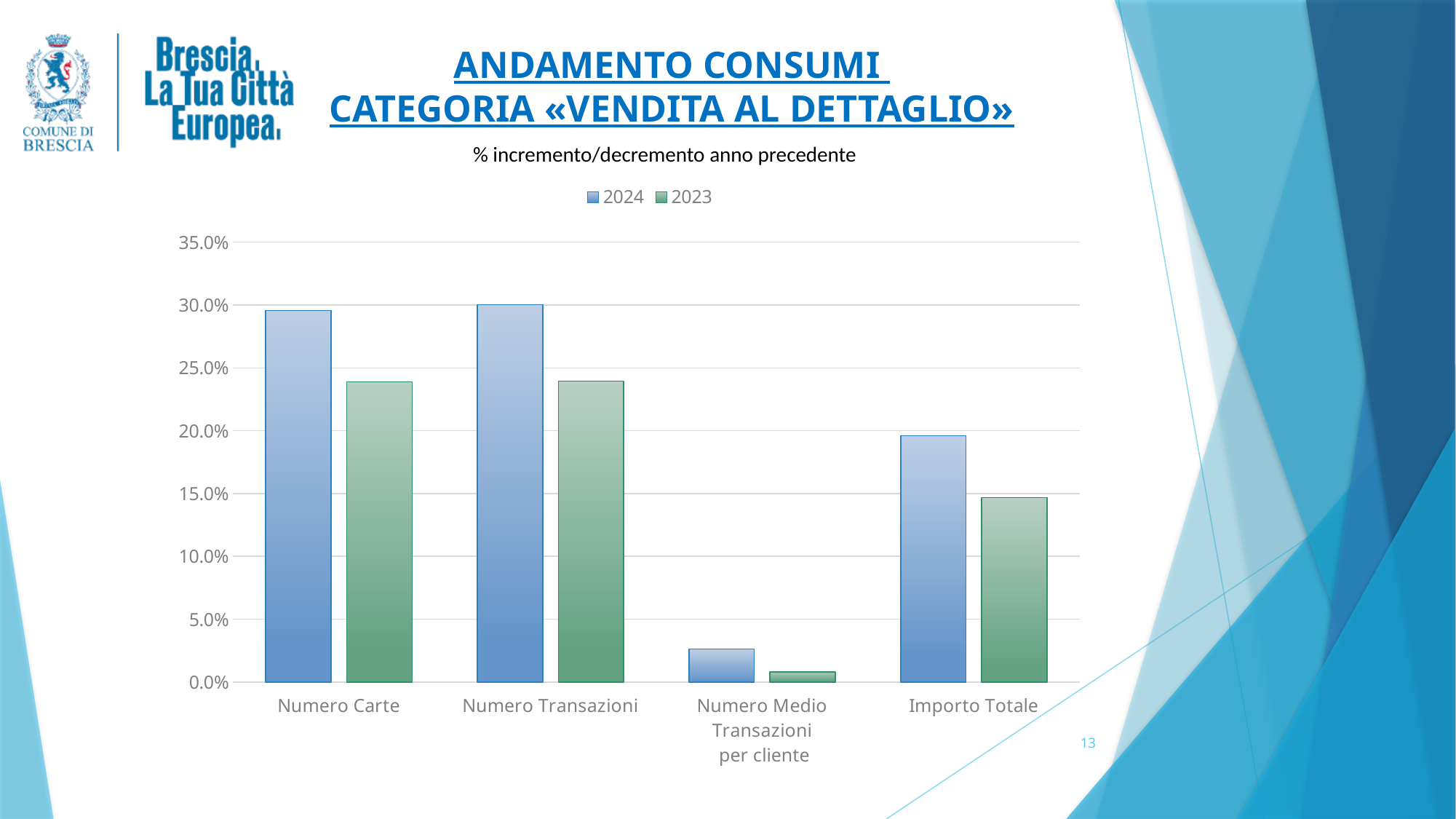
How many categories are shown on the x axis? 4 Is the 2024 value for Importo Totale greater or less than 20.0%? less What is the title of the chart? % incremento/decremento anno precedente For Importo Totale, which series has the larger value, 2024 or 2023? 2024 Which is larger: the 2024 value for Numero Carte or the 2024 value for Importo Totale? Numero Carte Which category has the lowest value for the 2023 series? Numero Medio Transazioni per cliente Is the 2023 value for Importo Totale greater or less than 15.0%? less What kind of chart is shown on the slide? bar chart How many series does the legend list? 2 Is the 2023 value for Numero Transazioni greater or less than 20.0%? greater Which category has the lowest value for the 2024 series? Numero Medio Transazioni per cliente